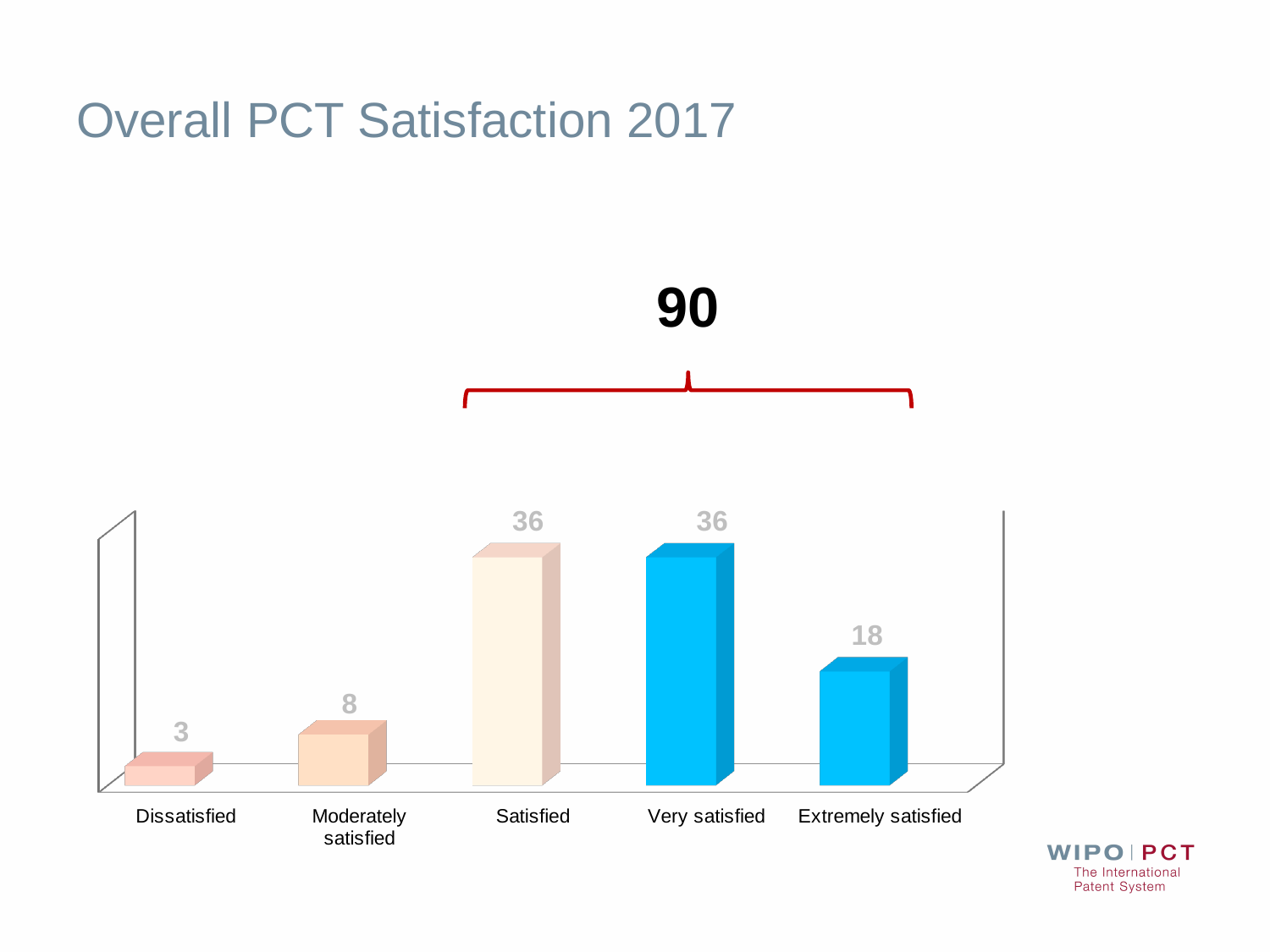
What kind of chart is shown on the slide? Bar chart Which is larger, the value for Extremely satisfied or the value for Moderately satisfied? Extremely satisfied What is the value for Dissatisfied? 3 What number is shown above the bracket spanning Satisfied, Very satisfied and Extremely satisfied? 90 What is the value for Extremely satisfied? 18 What is the value for Moderately satisfied? 8 Which category has the lowest value? Dissatisfied What is the difference between the values for Very satisfied and Extremely satisfied? 18 How many categories are shown on the x axis? 5 What is the value for Very satisfied? 36 What is the difference between the values for Moderately satisfied and Dissatisfied? 5 What is the title of the slide? Overall PCT Satisfaction 2017